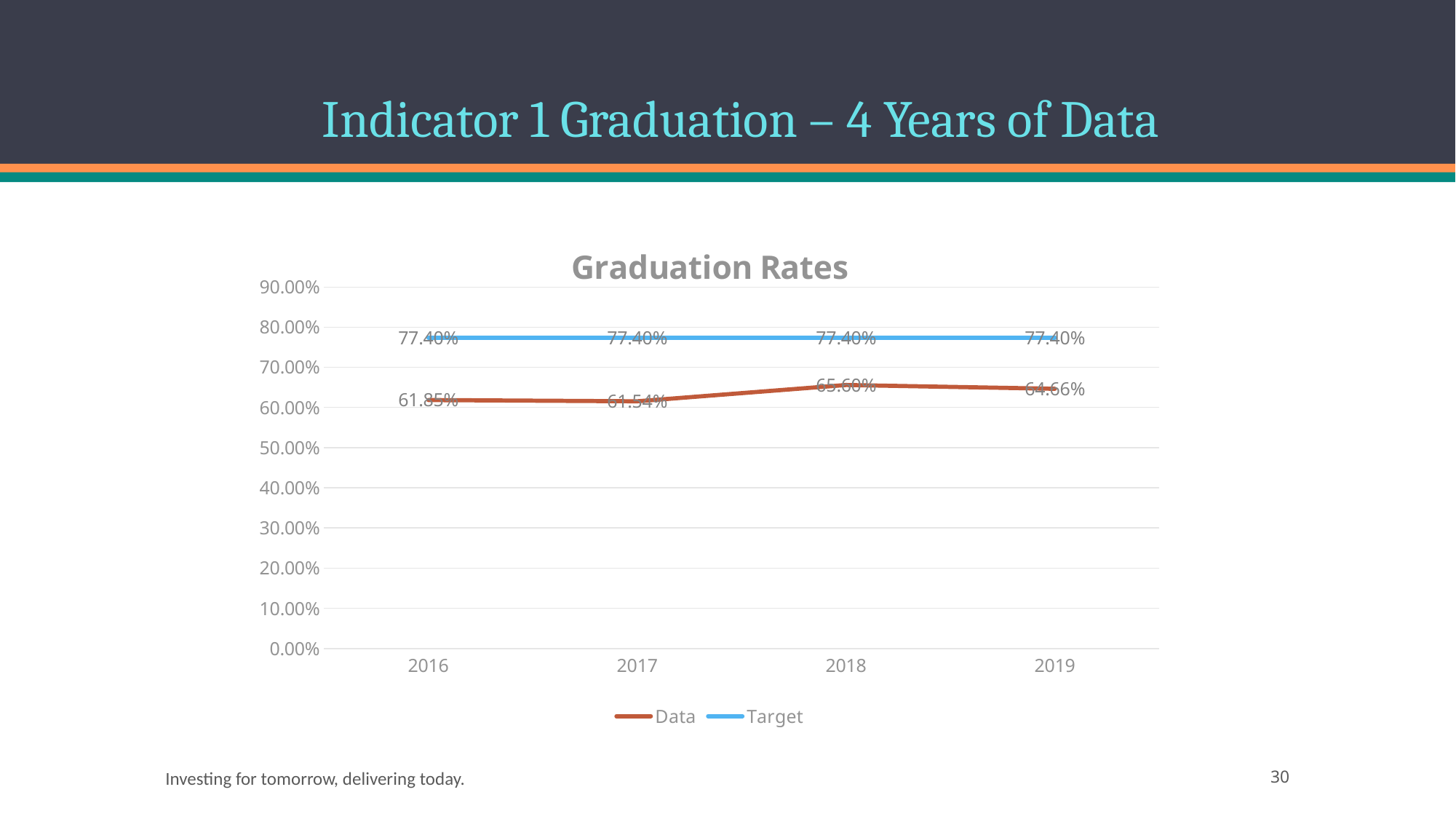
What is the difference between the Data values for 2018 and 2017? 4.06% In which year is the Data series highest? 2018 What is the Data value for 2018? 65.60% How many series does the legend list? 2 In which year is the Data series lowest? 2017 What is the Target value for 2019? 77.40% What kind of chart is shown? line chart Which is larger in 2016, the Data value or the Target value? Target Is the Data value for 2019 greater or less than 70.00%? less What is the difference between the Target and the Data value in 2019? 12.74% What is the Data value for 2016? 61.85% How many years are shown on the x axis? 4